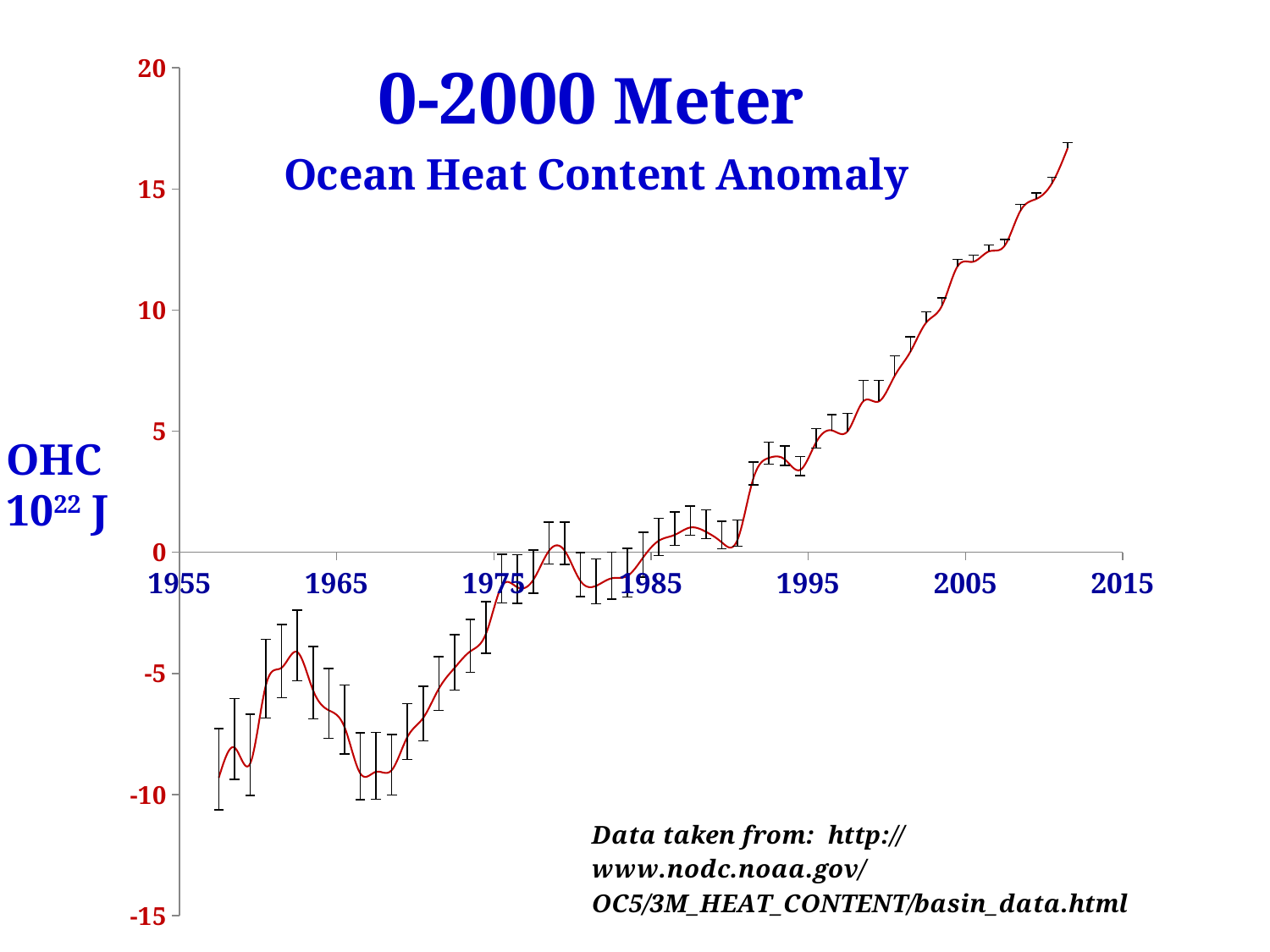
What is the title of the chart? 0-2000 Meter Ocean Heat Content Anomaly Is the value for 1995 greater or less than 0? greater Is the value for 1975 greater or less than 0? less Is the value for 2005 greater or less than 10? greater Between 1995 and 2010, does the plotted line rise or fall? rise What is the label on the y axis of the chart? OHC 10^22 J What kind of chart is shown on the slide? line chart Which year has the larger value, 1965 or 2005? 2005 Overall, does the ocean heat content anomaly rise or fall from 1955 to the end of the series? rise Which year has the larger value, 1975 or 1995? 1995